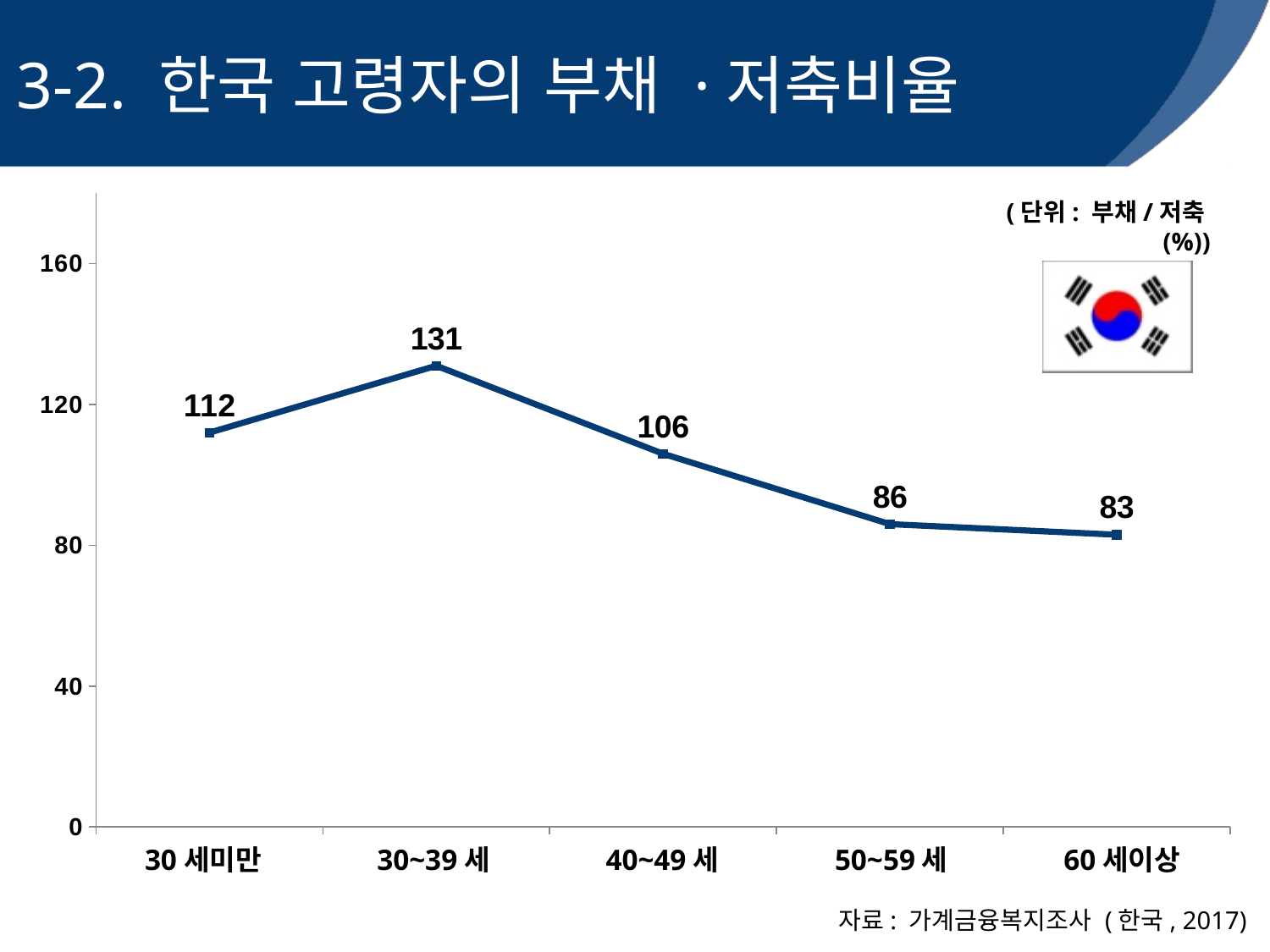
What is the difference between the values for 30 세미만 and 60 세이상? 29 Which age group has the lowest value? 60 세이상 What is the value for the 30~39 세 age group? 131 What kind of chart is shown on the slide? line chart What is the value for the 30 세미만 age group? 112 Which age group has the highest value? 30~39 세 Do the values rise or fall from 30~39 세 to 60 세이상? fall Which is larger, the value for 40~49 세 or the value for 50~59 세? 40~49 세 Is the value for 50~59 세 greater or less than 120? less What is the value for the 60 세이상 age group? 83 What is the difference between the values for 30~39 세 and 40~49 세? 25 How many age groups are plotted on the chart? 5